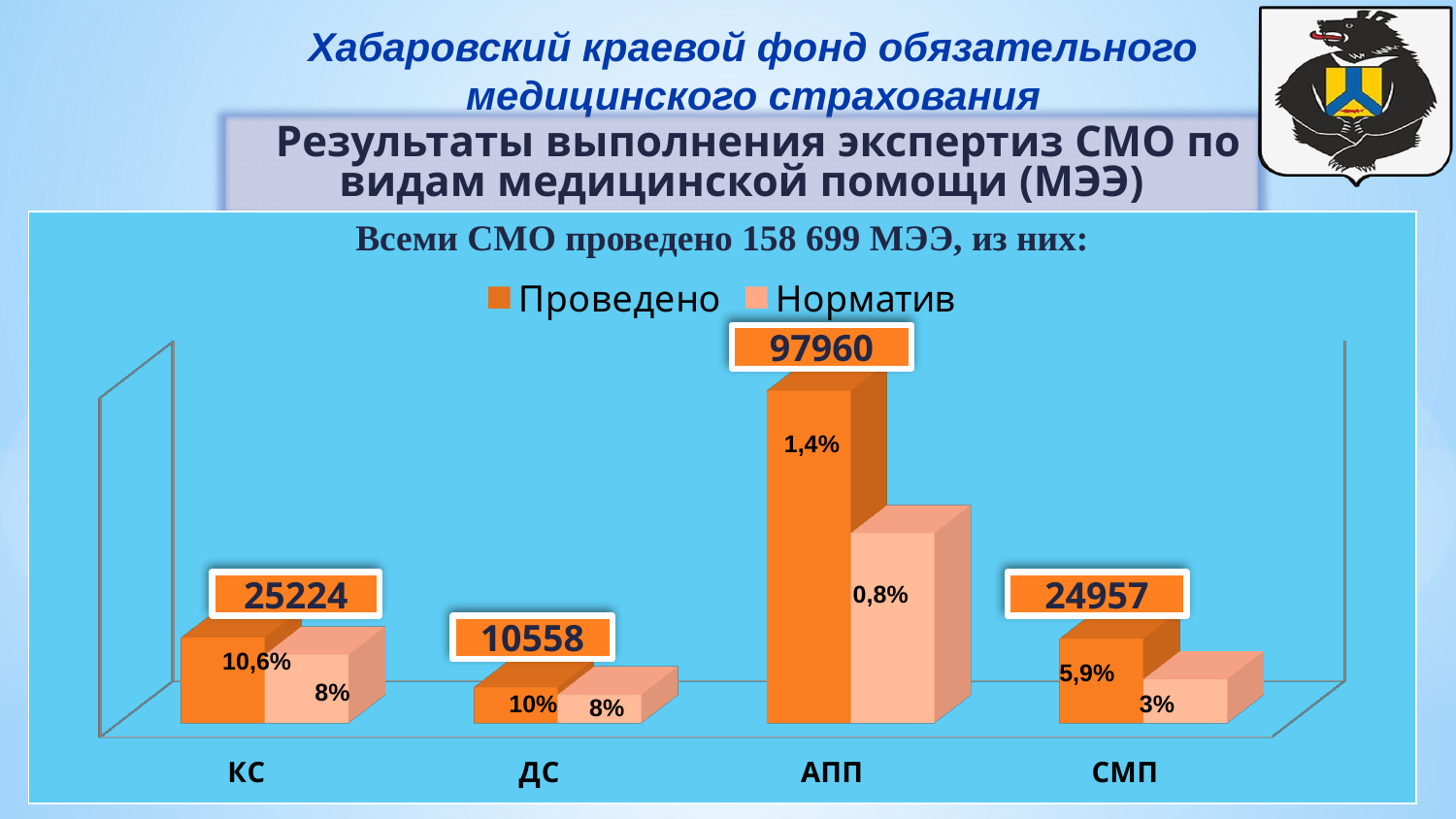
What is the difference between the Проведено values for КС and СМП? 267 Which category has the highest Проведено value? АПП What value is labelled on the Проведено bar for КС? 25224 Which is larger, the Проведено value for АПП or for КС? АПП What percentage is shown on the Норматив bar for СМП? 3% How many categories are shown on the x axis? 4 What value is labelled on the Проведено bar for АПП? 97960 What percentage is shown on the Проведено bar for КС? 10,6% How many series does the legend list? 2 Which category has the lowest Проведено value? ДС What kind of chart is shown on the slide? Bar chart What percentage is shown on the Норматив bar for АПП? 0,8%